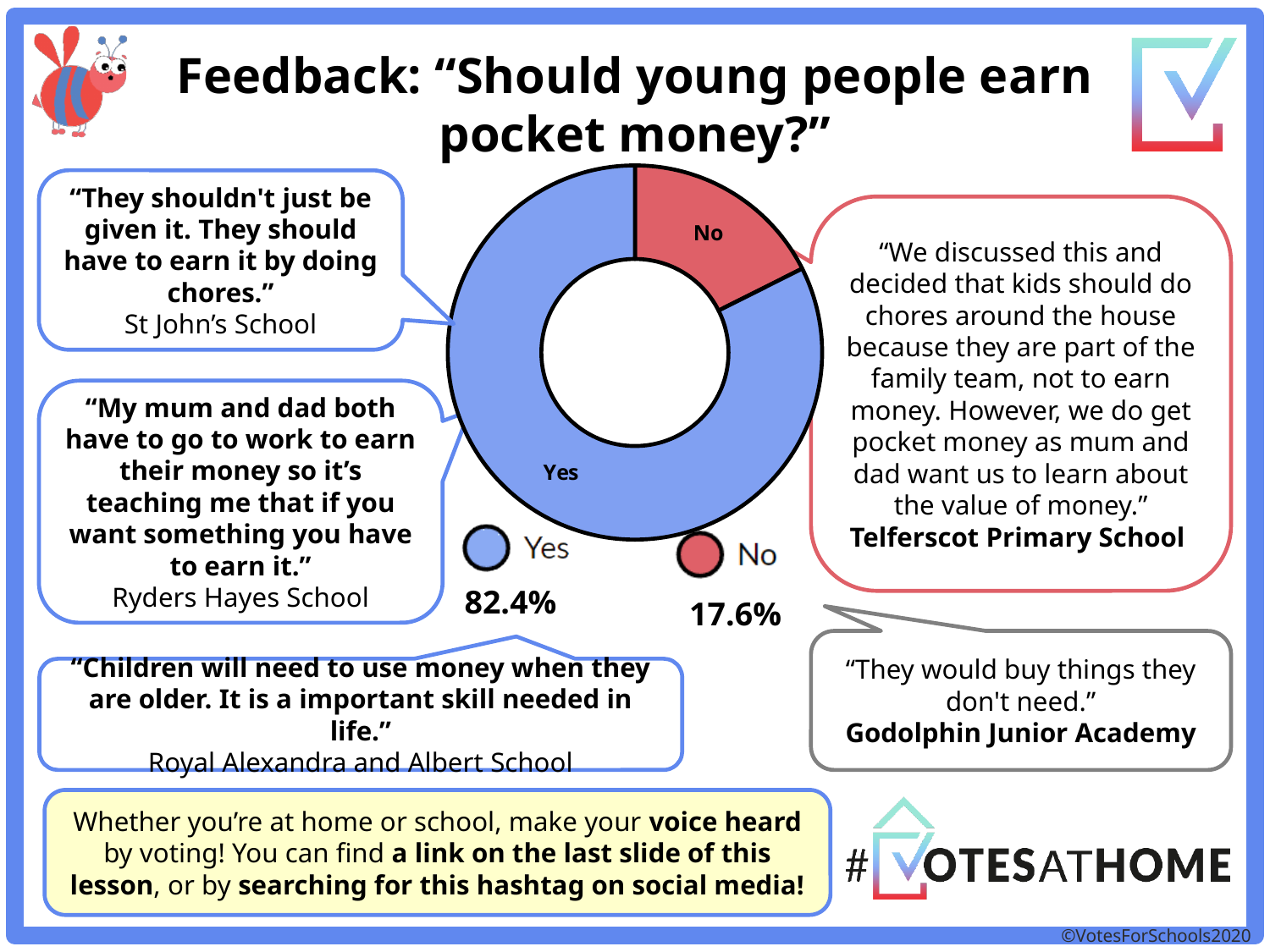
What percentage of respondents answered Yes? 82.4% What is the total of the Yes and No percentages? 100% Which is larger, the Yes share or the No share? Yes What colour represents the Yes response in the chart? Blue What is the difference between the Yes and No percentages? 64.8% Which response has the largest share of the chart? Yes What colour represents the No response in the chart? Red Which response has the smallest share of the chart? No How many entries does the legend list? 2 What kind of chart is shown on the slide? Doughnut (pie) chart How many categories does the chart show? 2 What percentage of respondents answered No? 17.6%